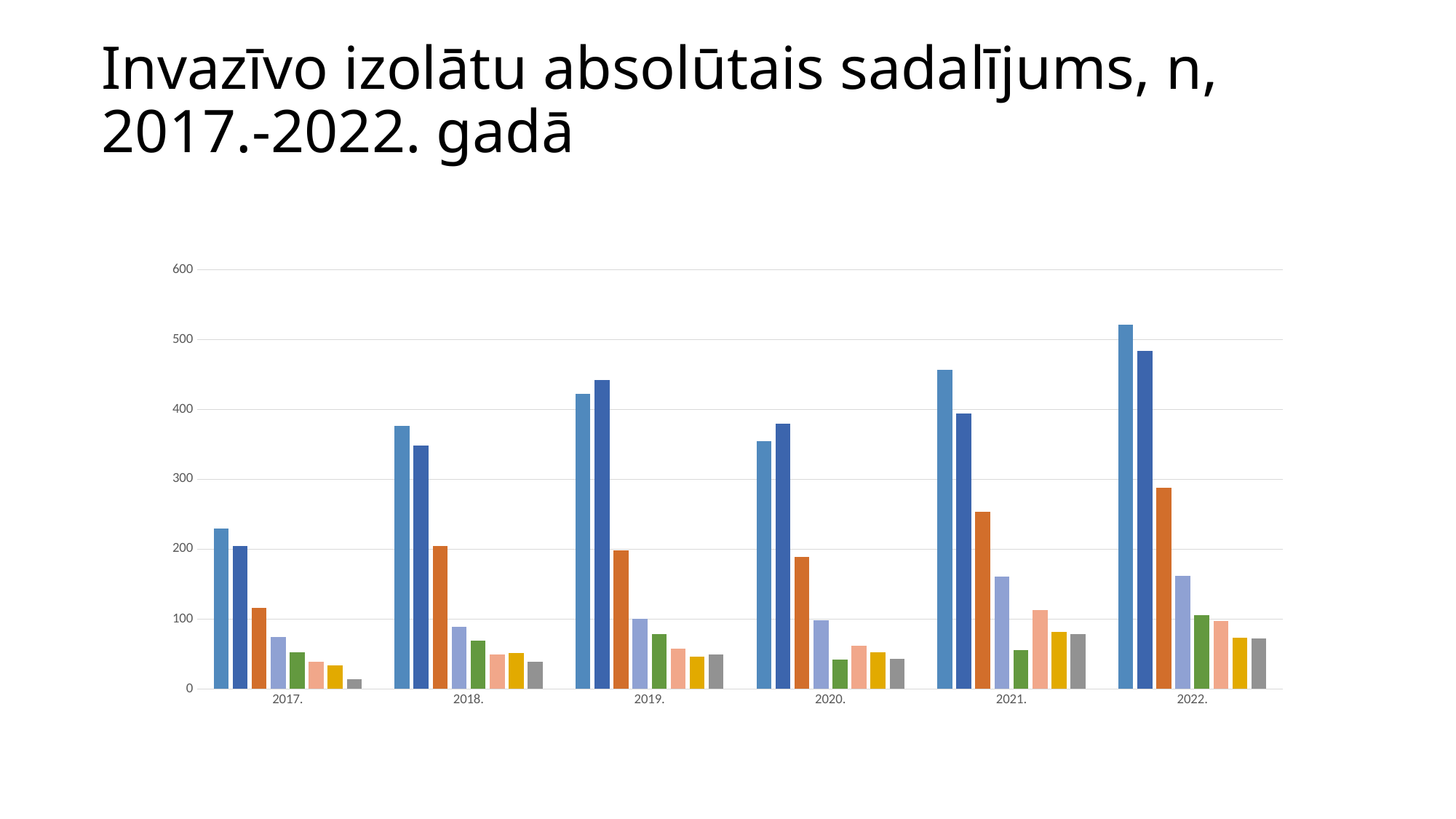
How many year categories are shown on the x axis? 6 In which year is the gray bar the shortest? 2017. In 2019., which is taller: the light blue bar or the dark blue bar? the dark blue bar How many bars are plotted for each year group? 8 Is the value of the light blue bar for 2017. greater or less than 200? greater Is the value of the dark blue bar for 2022. greater or less than 500? less In which year is the light blue bar the tallest? 2022. Is the value of the tallest (light blue) bar for 2022. greater or less than 500? greater What kind of chart is shown on the slide? bar chart What is the title of the chart on the slide? Invazīvo izolātu absolūtais sadalījums, n, 2017.-2022. gadā